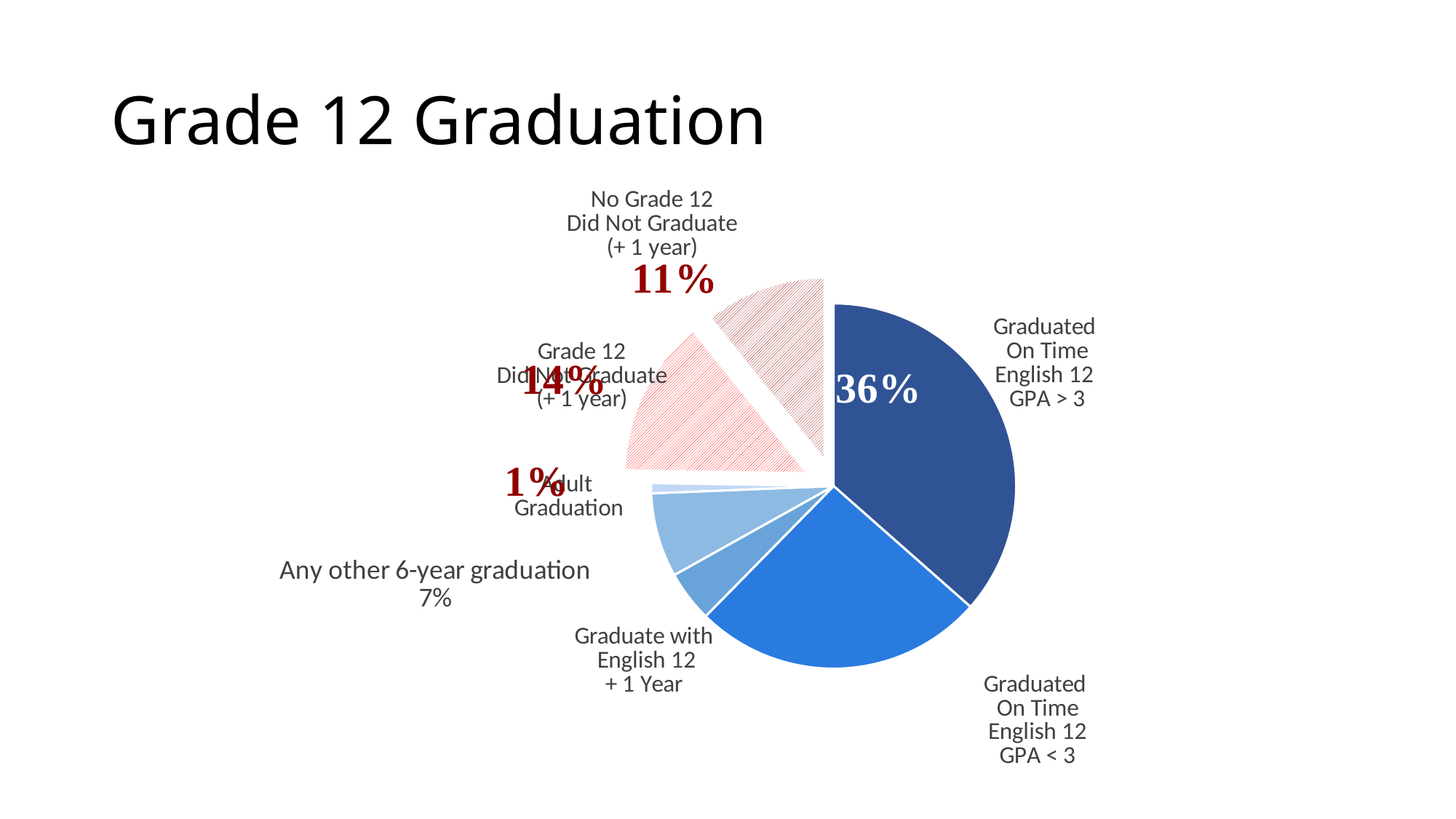
Which slice of the pie is the largest? Graduated On Time English 12 GPA > 3 Which slice of the pie is the smallest? Adult Graduation What percentage is shown for Any other 6-year graduation? 7% What kind of chart is shown on the slide? pie chart What share of the pie is labelled for Graduated On Time English 12 GPA > 3? 36% What percentage is shown for No Grade 12 Did Not Graduate (+ 1 year)? 11% What is the difference between the Grade 12 Did Not Graduate (+ 1 year) share and the No Grade 12 Did Not Graduate (+ 1 year) share? 3% What percentage is shown for Grade 12 Did Not Graduate (+ 1 year)? 14% What percentage is shown for Adult Graduation? 1% Which is larger: the Grade 12 Did Not Graduate (+ 1 year) slice or the No Grade 12 Did Not Graduate (+ 1 year) slice? Grade 12 Did Not Graduate (+ 1 year) What is the title of the slide containing the pie chart? Grade 12 Graduation How many slices does the pie chart have? 7